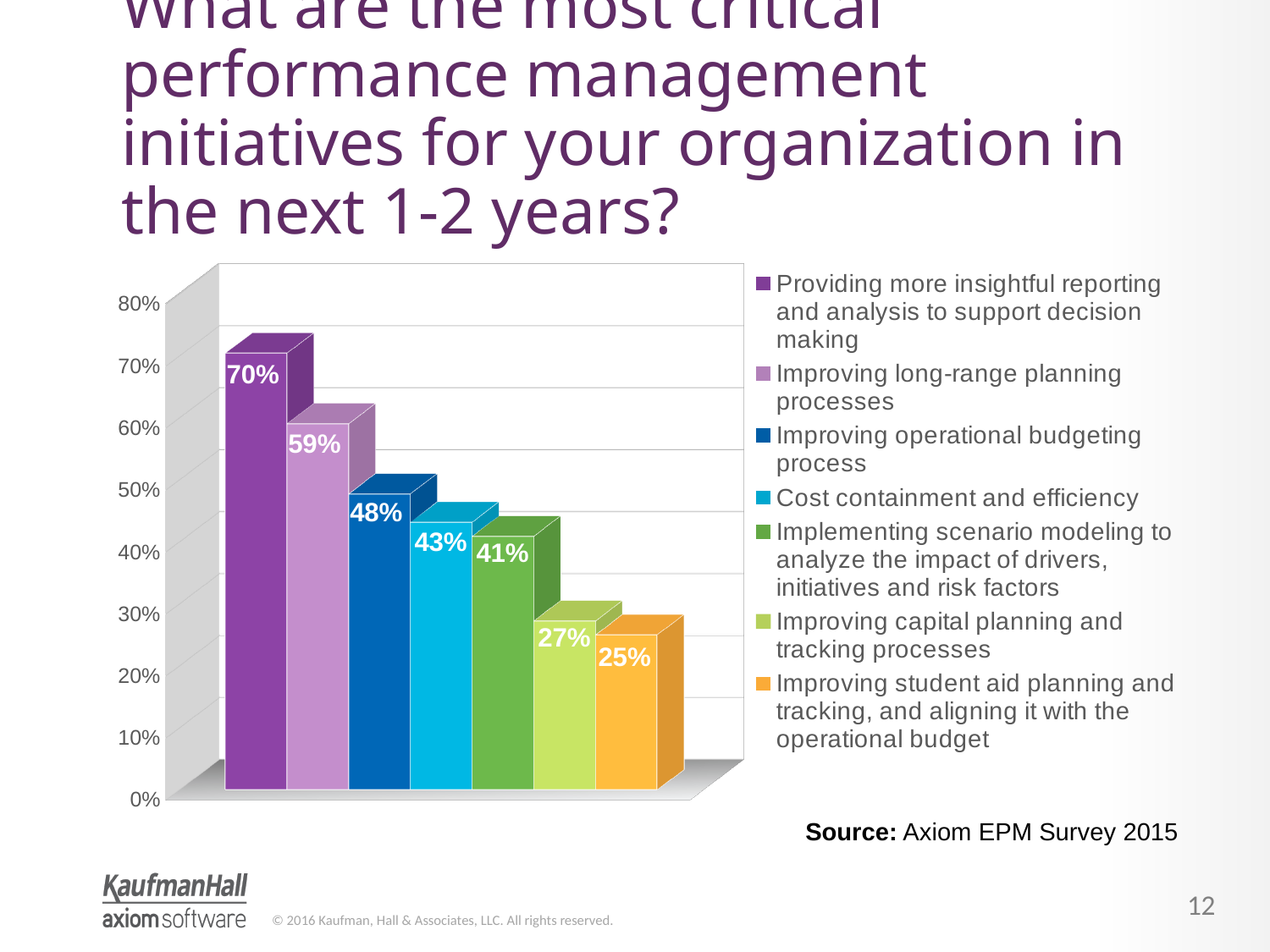
What kind of chart is shown on the slide? Bar chart What is the source cited for the chart data? Axiom EPM Survey 2015 What is the value for 'Cost containment and efficiency'? 43% Is the value for 'Improving capital planning and tracking processes' greater or less than 30%? less What is the difference between 'Improving long-range planning processes' and 'Improving operational budgeting process'? 11% How many entries does the legend list? 7 What is the value for 'Improving student aid planning and tracking, and aligning it with the operational budget'? 25% What percentage of respondents selected 'Providing more insightful reporting and analysis to support decision making'? 70% How many initiatives are plotted in the chart? 7 Which initiative has the highest value? Providing more insightful reporting and analysis to support decision making Which is larger: 'Cost containment and efficiency' or 'Implementing scenario modeling to analyze the impact of drivers, initiatives and risk factors'? Cost containment and efficiency Which initiative has the lowest value? Improving student aid planning and tracking, and aligning it with the operational budget